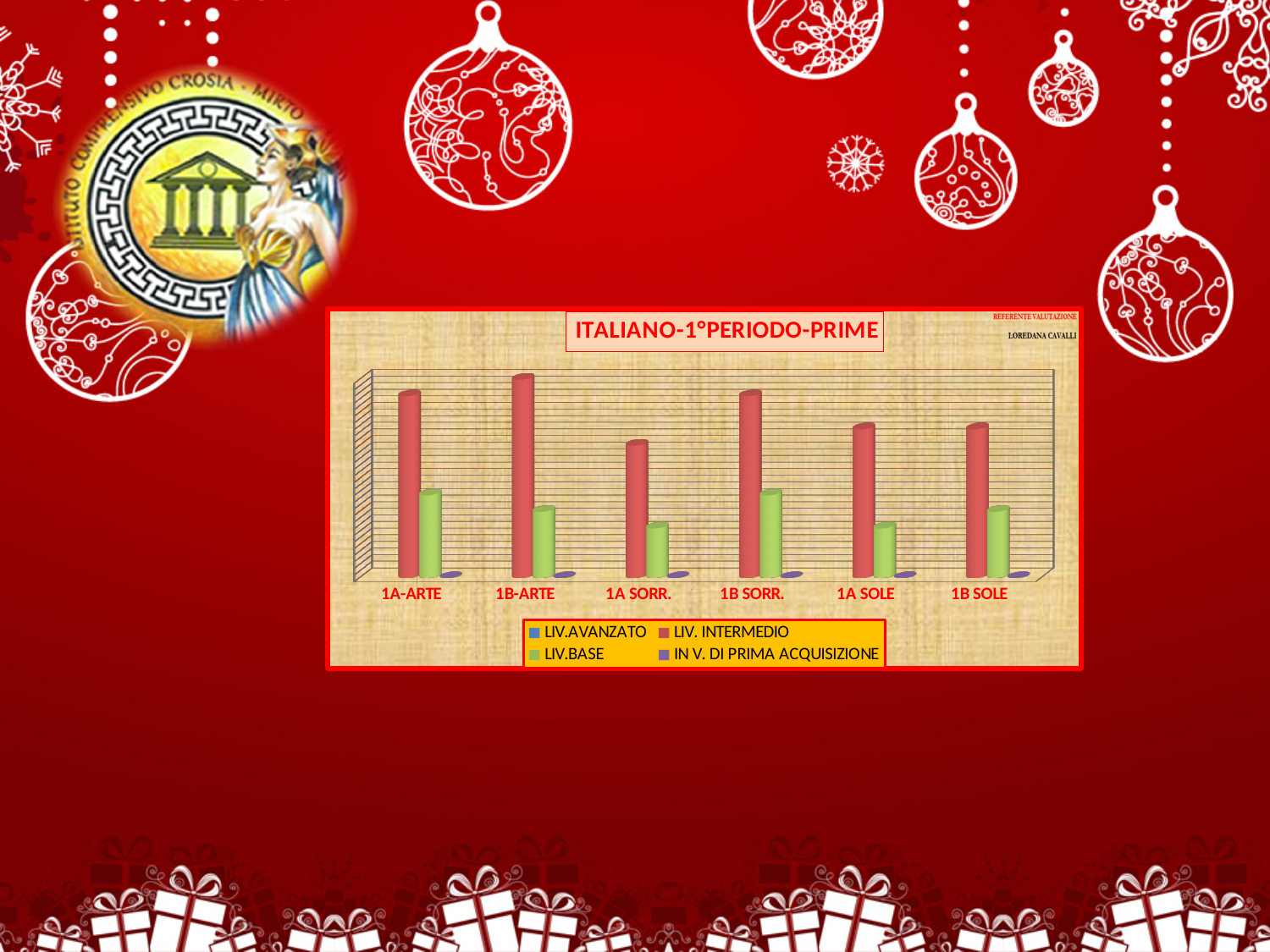
How many categories are shown on the x axis of the chart? 6 Which has the larger LIV.BASE value, 1A-ARTE or 1A SORR.? 1A-ARTE Which category has the highest LIV. INTERMEDIO bar? 1B-ARTE What colour are the LIV.BASE bars in the chart? green Which has the larger LIV. INTERMEDIO value, 1B-ARTE or 1A SORR.? 1B-ARTE Which has the larger LIV. INTERMEDIO value, 1B SORR. or 1B SOLE? 1B SORR. What is the title of the chart? ITALIANO-1°PERIODO-PRIME What kind of chart is shown on the slide? bar chart How many series does the chart's legend list? 4 Which category has the lowest LIV. INTERMEDIO bar? 1A SORR.